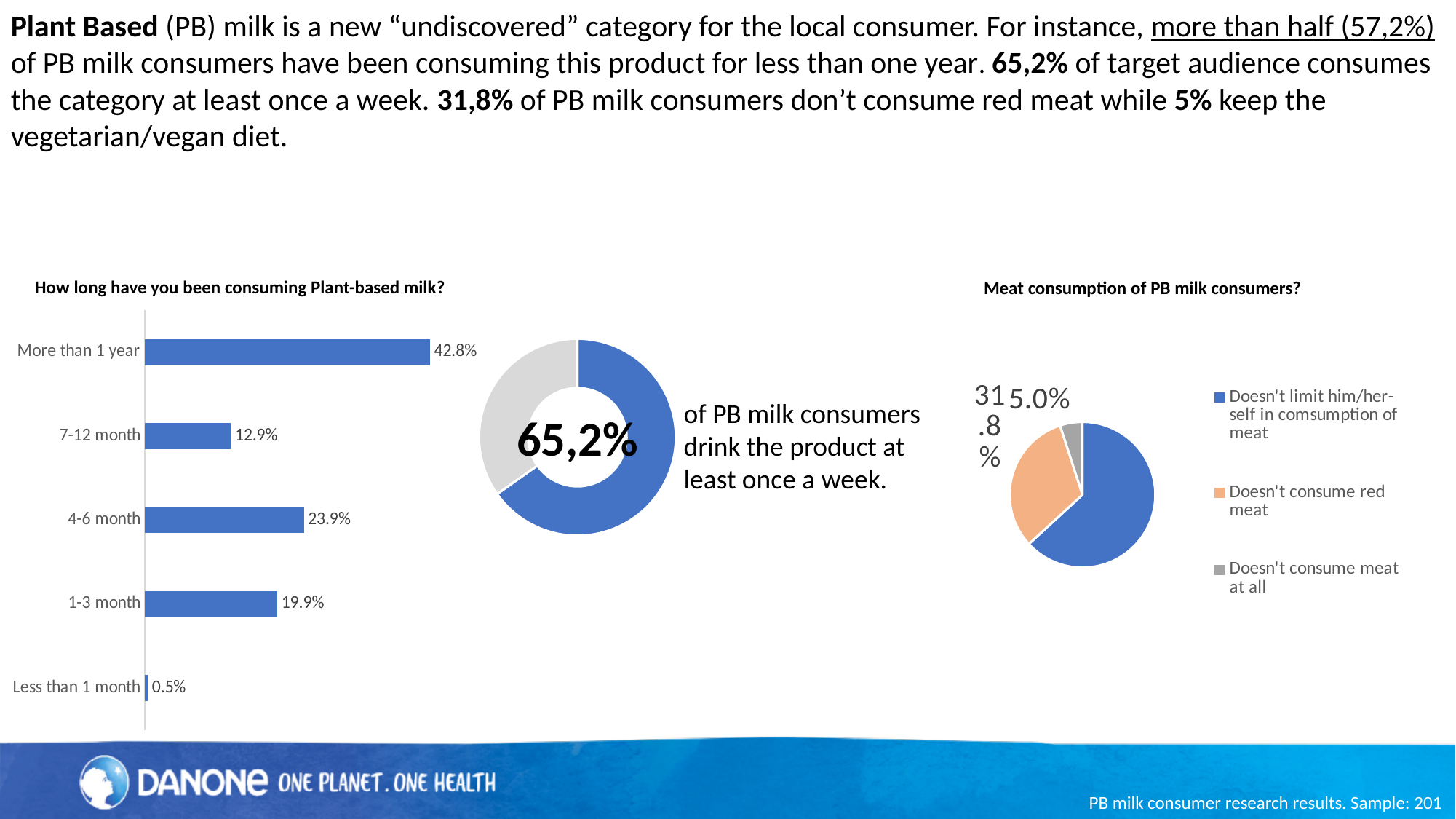
In the chart 'How long have you been consuming Plant-based milk?', what is the value for 'Less than 1 month'? 0.5% In the chart 'Meat consumption of PB milk consumers?', which category has the largest slice? Doesn't limit him/her-self in comsumption of meat In the chart 'How long have you been consuming Plant-based milk?', what is the difference between the values for '4-6 month' and '1-3 month'? 4.0% What value is printed in the centre of the donut chart in the middle of the slide? 65,2% In the chart 'How long have you been consuming Plant-based milk?', which category has the lowest value? Less than 1 month What kind of chart is 'How long have you been consuming Plant-based milk?'? Bar chart In the chart 'Meat consumption of PB milk consumers?', what is the share for 'Doesn't consume meat at all'? 5.0% In the chart 'How long have you been consuming Plant-based milk?', which is larger: the value for '7-12 month' or the value for '1-3 month'? 1-3 month In the chart 'How long have you been consuming Plant-based milk?', which category has the highest value? More than 1 year In the chart 'How long have you been consuming Plant-based milk?', what is the value for 'More than 1 year'? 42.8% In the chart 'How long have you been consuming Plant-based milk?', what is the value for '4-6 month'? 23.9% How many categories are shown in the chart 'How long have you been consuming Plant-based milk?'? 5